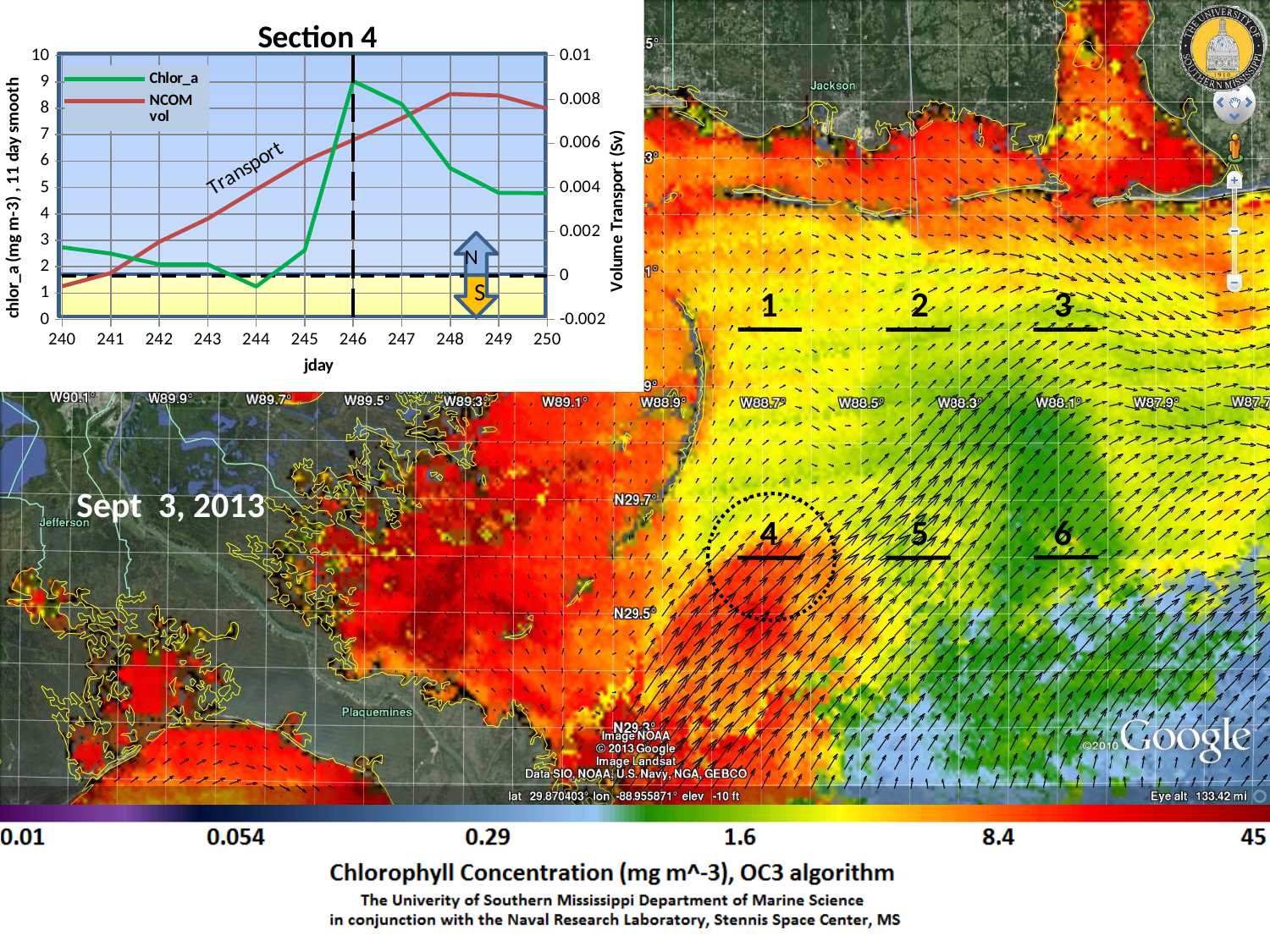
In the 'Section 4' chart, is the NCOM vol value at jday 240 greater or less than 0? less In the 'Section 4' chart, is the Chlor_a value at jday 246 greater or less than 8? greater How many series does the legend of the 'Section 4' chart list? 2 In the 'Section 4' chart, at which jday is Chlor_a at its lowest value? 244 What are the two series named in the legend of the 'Section 4' chart? Chlor_a and NCOM vol In the 'Section 4' chart, which is larger: Chlor_a at jday 246 or Chlor_a at jday 250? jday 246 What is the x-axis label of the 'Section 4' chart? jday In the 'Section 4' chart, at which jday does Chlor_a reach its highest value? 246 In the 'Section 4' chart, is the Chlor_a value at jday 244 greater or less than 2? less In the 'Section 4' chart, does the NCOM vol series rise or fall between jday 240 and jday 248? rise How many jday tick labels are shown on the x axis of the 'Section 4' chart? 11 What kind of chart is the 'Section 4' chart? line chart